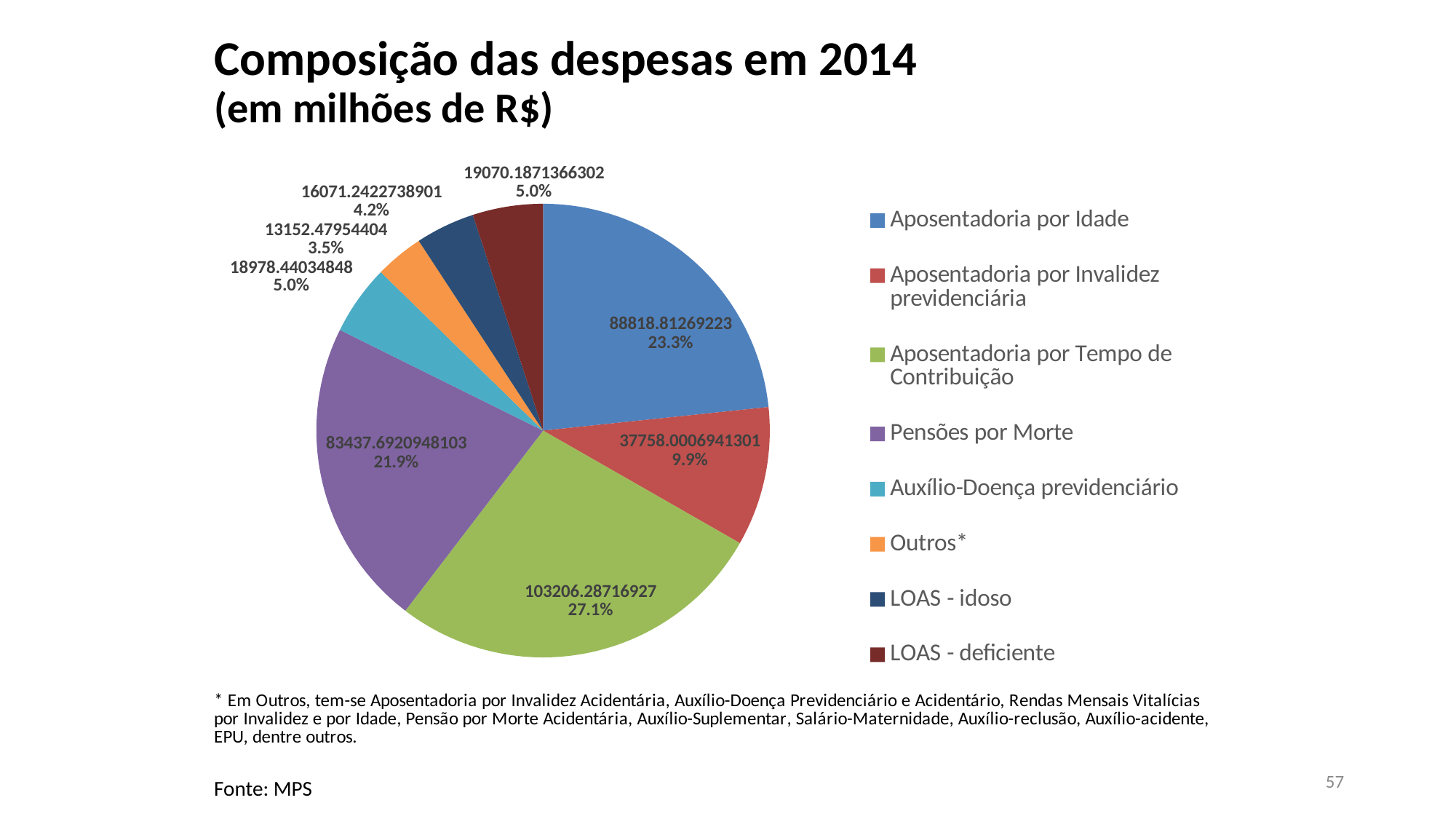
Which category has the smallest slice of the pie? Outros* What is the difference in percentage points between the share of Aposentadoria por Tempo de Contribuição and the share of Aposentadoria por Idade? 3.8 percentage points What share of the pie does Pensões por Morte represent? 21.9% What kind of chart is shown on the slide? pie chart What is the value shown for LOAS - deficiente? 19070.1871366302 Which is larger, the share for LOAS - idoso or the share for Outros*? LOAS - idoso Which category has the largest slice of the pie? Aposentadoria por Tempo de Contribuição What is the value shown for Aposentadoria por Invalidez previdenciária? 37758.0006941301 What share of the pie does Aposentadoria por Tempo de Contribuição represent? 27.1% How many slices does the pie chart have? 8 What is the title of the chart? Composição das despesas em 2014 (em milhões de R$) What share of the pie does Aposentadoria por Idade represent? 23.3%